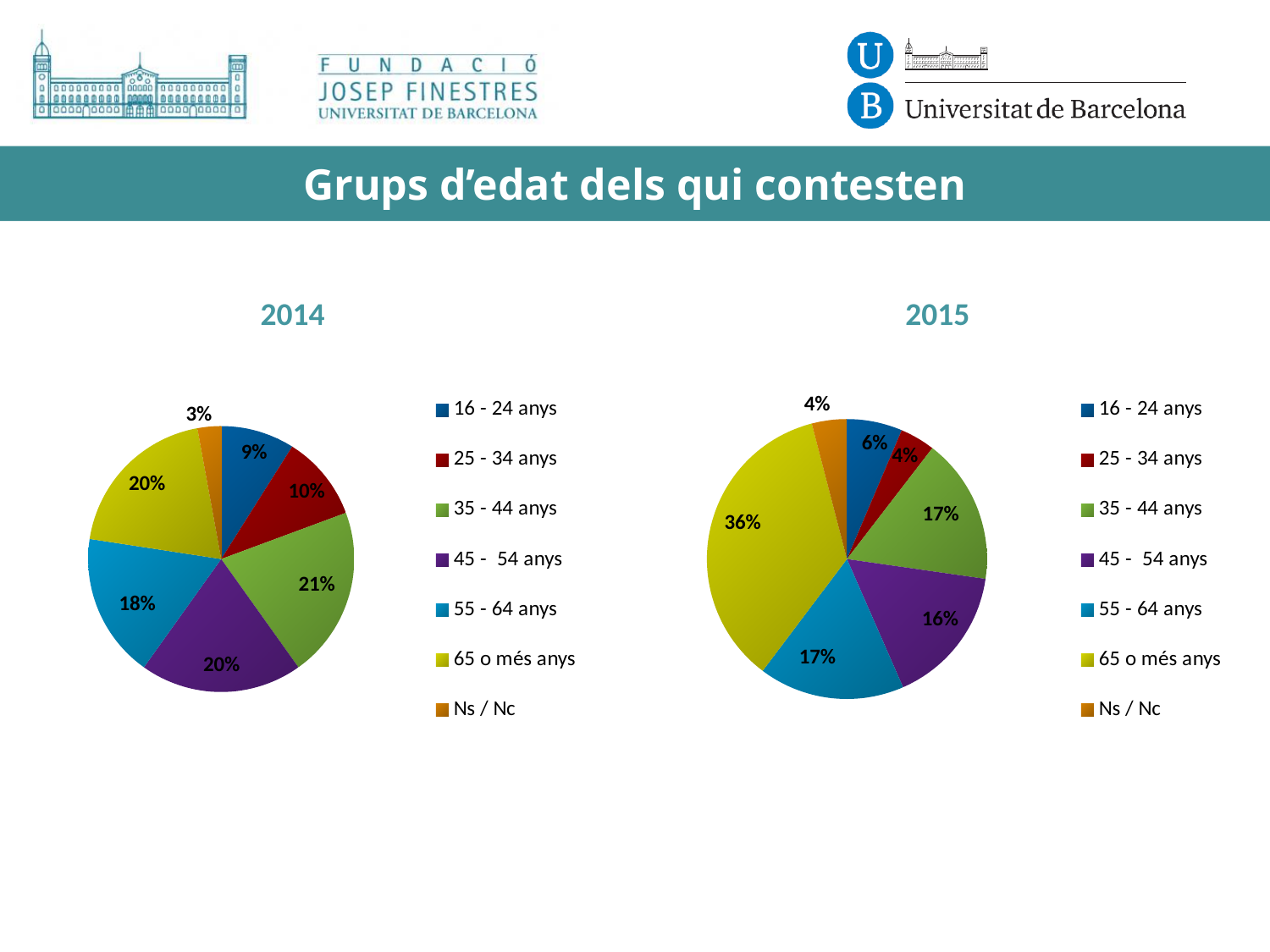
In the 2015 pie chart, which age group has the largest share? 65 o més anys In the 2015 pie chart, which is larger: the share for 45 - 54 anys or the share for 55 - 64 anys? 55 - 64 anys What is the difference between the share for 65 o més anys in the 2015 chart and in the 2014 chart? 16 percentage points In the 2014 pie chart, which category has the largest share? 35 - 44 anys In the 2015 pie chart, what is the share for 16 - 24 anys? 6% What is the title of the slide containing the two charts? Grups d'edat dels qui contesten In the 2014 pie chart, what is the share for 55 - 64 anys? 18% How many categories does the legend of the 2014 pie chart list? 7 In the 2015 pie chart, what is the share for 65 o més anys? 36% In the 2014 pie chart, what is the share for 35 - 44 anys? 21% In the 2014 pie chart, which category has the smallest share? Ns / Nc What type of chart is used for the 2015 data? Pie chart